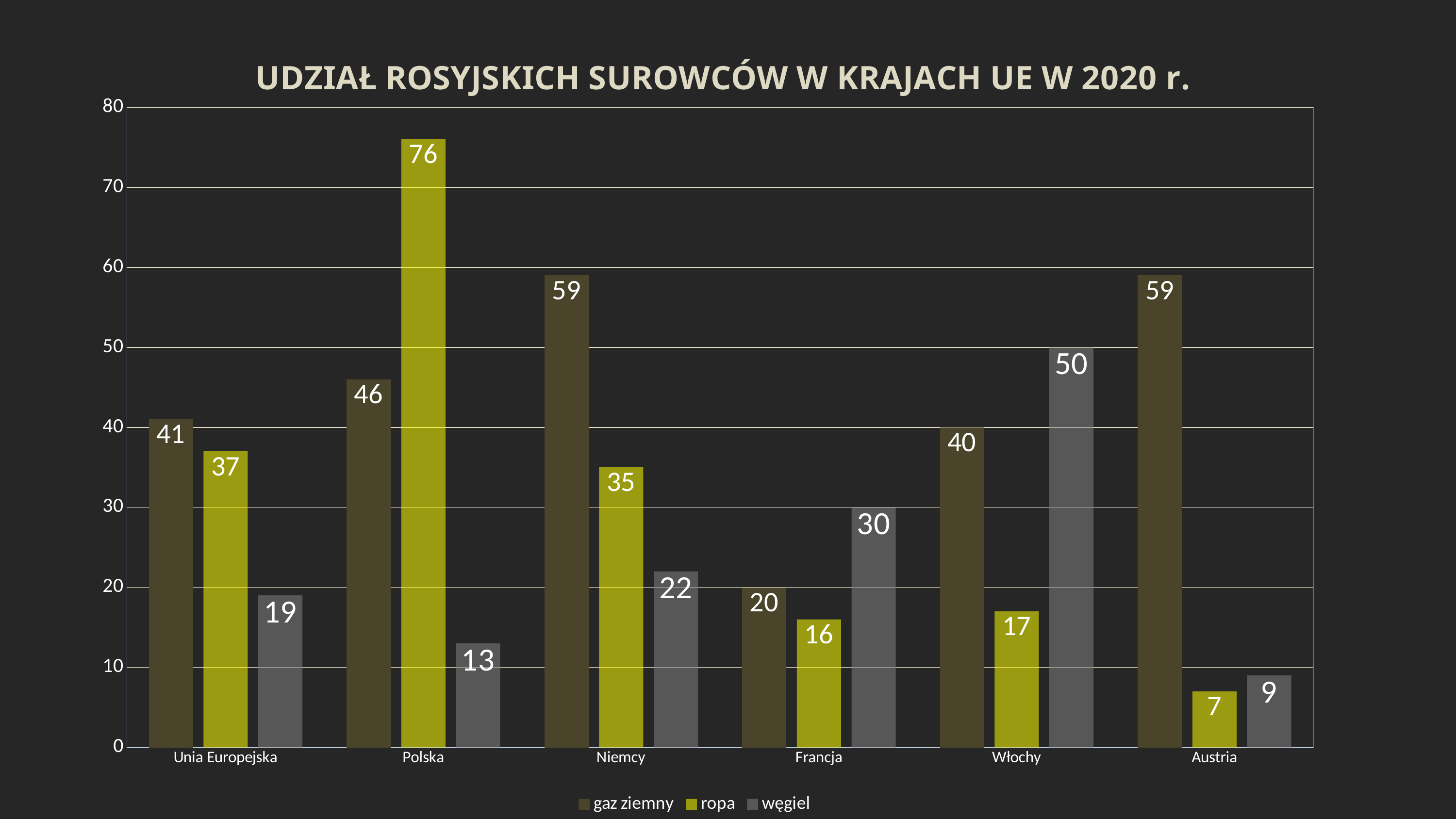
Which series is shown in yellow-green bars? ropa What is the value for ropa in Polska? 76 What is the value for węgiel in Włochy? 50 Which is larger: the węgiel value for Francja or the ropa value for Francja? węgiel value for Francja What kind of chart is shown on the slide? bar chart What is the difference between the gaz ziemny value for Niemcy and the gaz ziemny value for Francja? 39 What is the title of the chart? UDZIAŁ ROSYJSKICH SUROWCÓW W KRAJACH UE W 2020 r. What is the value for gaz ziemny in Francja? 20 How many series does the legend list? 3 How many categories are shown on the x axis? 6 Which category has the highest value for ropa? Polska Which category has the lowest value for węgiel? Austria